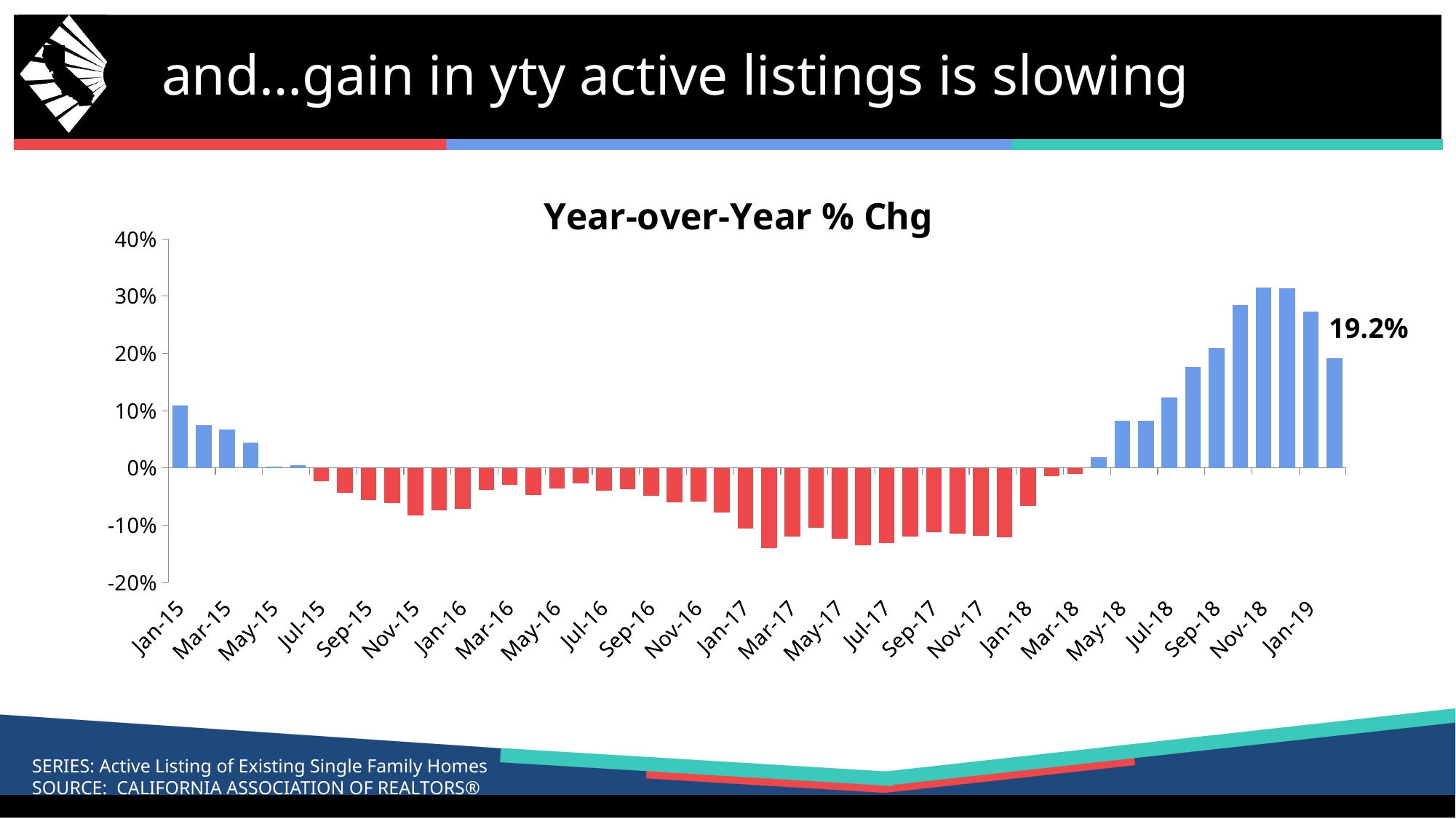
Is the value for Mar-18 greater or less than 10%? less Is the value for Jan-15 greater or less than 20%? less Which is larger, the value for Jan-17 or the value for Jan-18? Jan-18 What is the title of the chart? Year-over-Year % Chg Do the values rise or fall from Nov-18 to Jan-19? fall Is the value for Jan-19 greater or less than 20%? greater What colour are the bars with negative values? red Which is larger, the value for Nov-18 or the value for Jan-19? Nov-18 What kind of chart is shown on the slide? bar chart